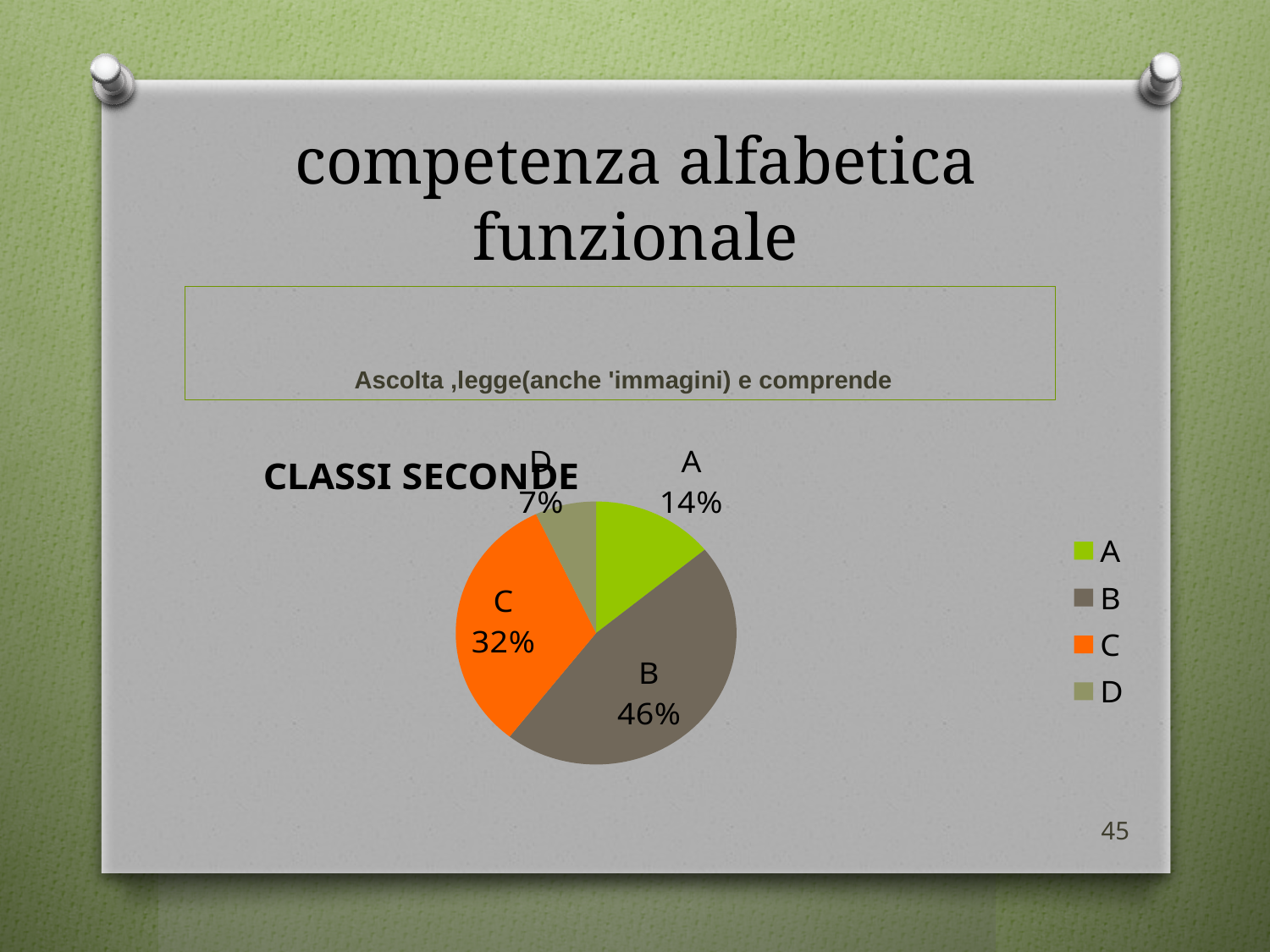
What is the value for category C in the pie chart? 32% What is the difference between the values for B and C? 14% What kind of chart is shown on the slide? pie chart What is the value for category D in the pie chart? 7% What is the value for category B in the pie chart? 46% How many entries does the legend list? 4 Which category has the largest slice of the pie chart? B How many categories does the pie chart have? 4 What is the value for category A in the pie chart? 14% Which is larger, the value for A or the value for C? C Which category has the smallest slice of the pie chart? D What colour is the slice for category C? orange